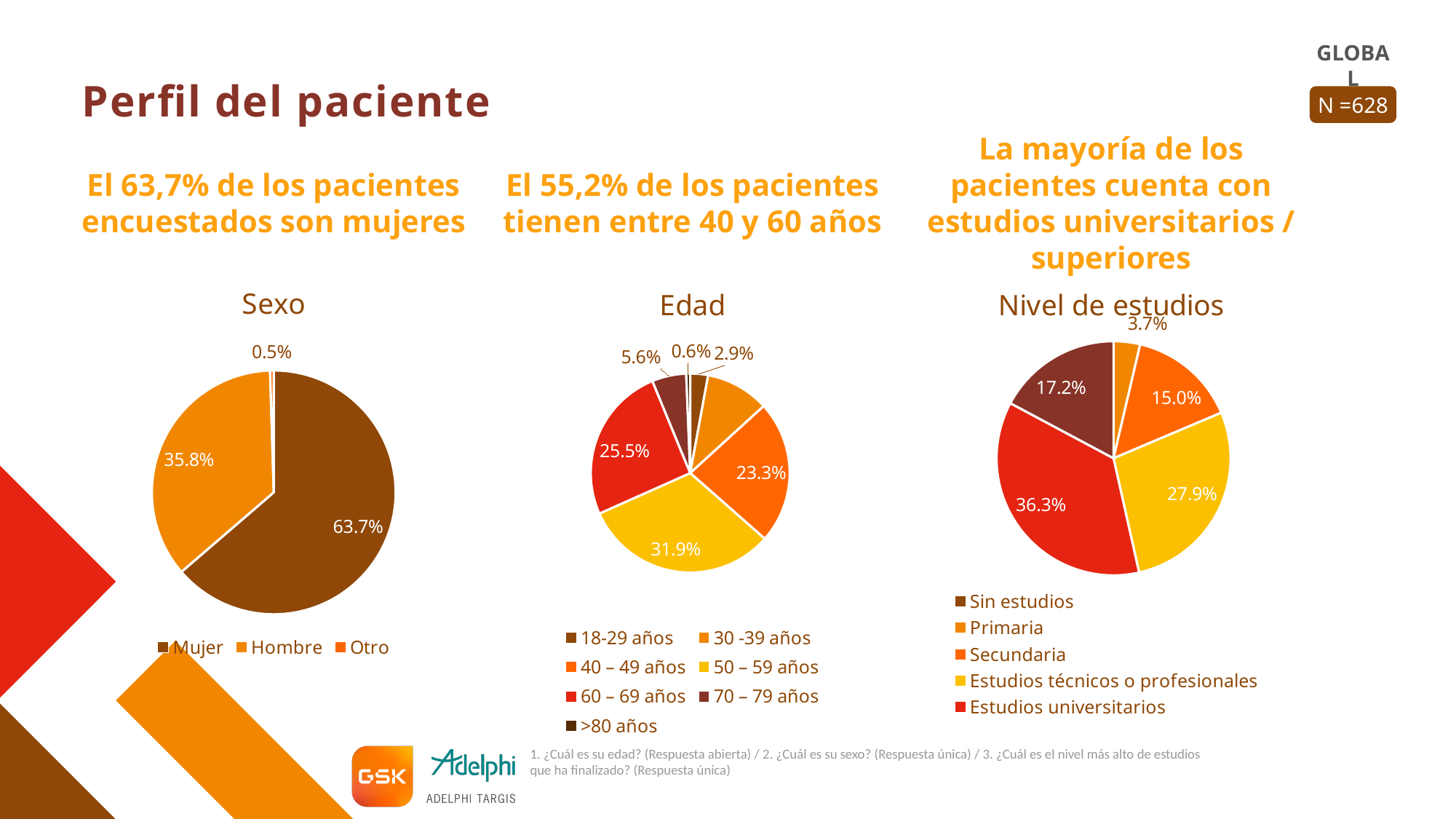
In the 'Nivel de estudios' pie chart, which is larger: 'Secundaria' or 'Estudios técnicos o profesionales'? Estudios técnicos o profesionales In the 'Edad' pie chart, what percentage of patients are '40 – 49 años'? 23.3% In the 'Sexo' pie chart, what is the difference between the 'Mujer' and 'Hombre' shares? 27.9% In the 'Sexo' pie chart, what percentage of patients are 'Hombre'? 35.8% In the 'Edad' pie chart, which age group has the largest share? 50 – 59 años In the 'Edad' pie chart, what percentage of patients are '50 – 59 años'? 31.9% What kind of chart is the 'Edad' chart? Pie chart In the 'Sexo' pie chart, which category has the smallest share? Otro In the 'Nivel de estudios' pie chart, what percentage of patients have 'Estudios universitarios'? 36.3% In the 'Nivel de estudios' pie chart, what is the difference between 'Estudios universitarios' and 'Estudios técnicos o profesionales'? 8.4% In the 'Sexo' pie chart, what percentage of patients are 'Mujer'? 63.7% How many age groups does the legend of the 'Edad' chart list? 7